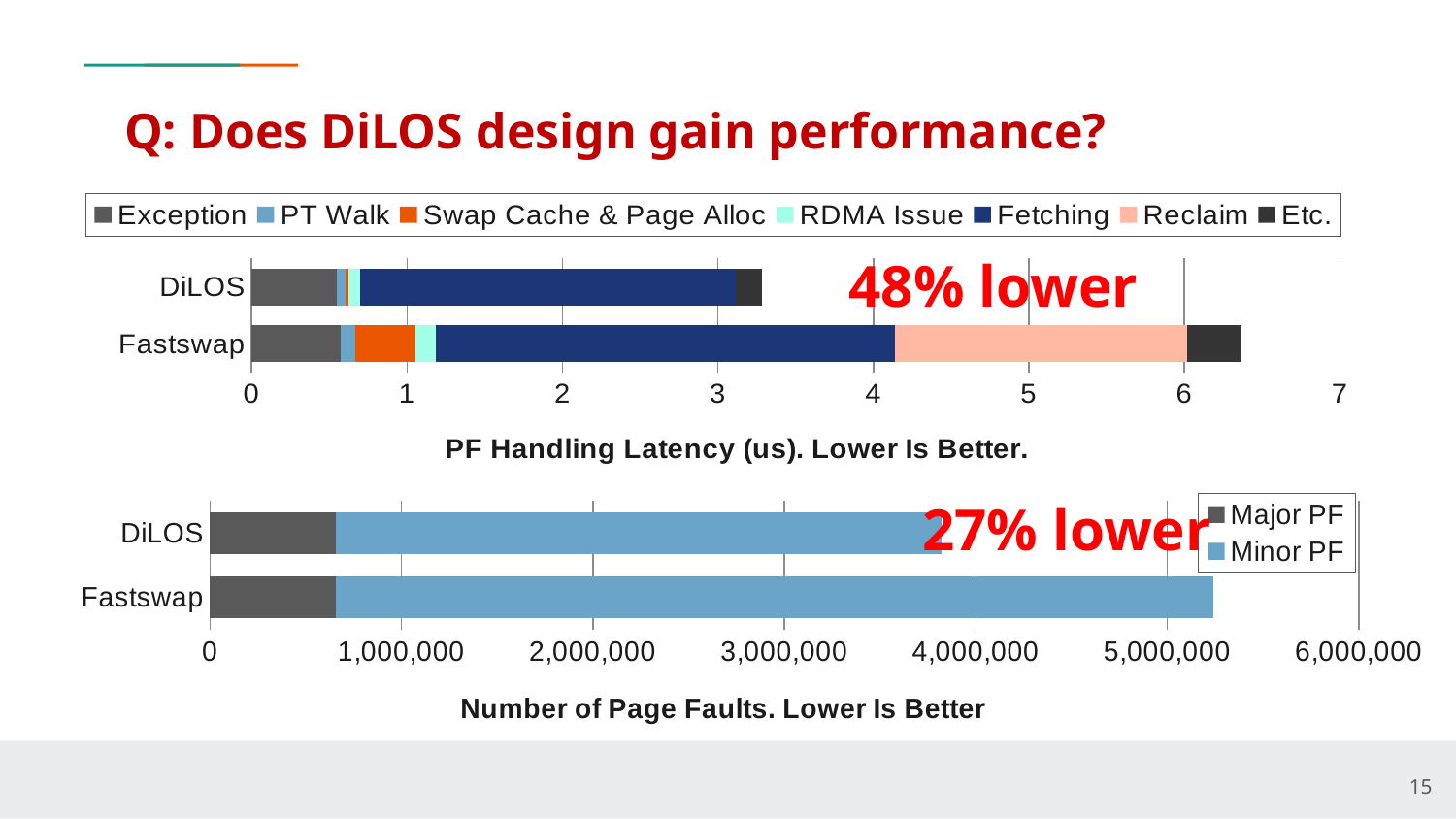
What kind of chart is the 'PF Handling Latency (us). Lower Is Better.' chart? Stacked bar chart In the 'PF Handling Latency (us). Lower Is Better.' chart, which category has the longer total bar? Fastswap In the 'PF Handling Latency (us). Lower Is Better.' chart, is the total latency for DiLOS greater or less than 4? less How many series does the legend of the 'Number of Page Faults. Lower Is Better' chart list? 2 In the 'PF Handling Latency (us). Lower Is Better.' chart, is the total latency for Fastswap greater or less than 6? greater In the 'PF Handling Latency (us). Lower Is Better.' chart, which category has a visible Reclaim segment? Fastswap In the 'Number of Page Faults. Lower Is Better' chart, is the total for Fastswap greater or less than 5,000,000? greater How many categories are shown in the 'PF Handling Latency (us). Lower Is Better.' chart? 2 In the 'Number of Page Faults. Lower Is Better' chart, which category has the lower total number of page faults? DiLOS According to the annotation on the 'Number of Page Faults. Lower Is Better' chart, by what percentage is DiLOS lower? 27% lower How many series does the legend of the 'PF Handling Latency (us). Lower Is Better.' chart list? 7